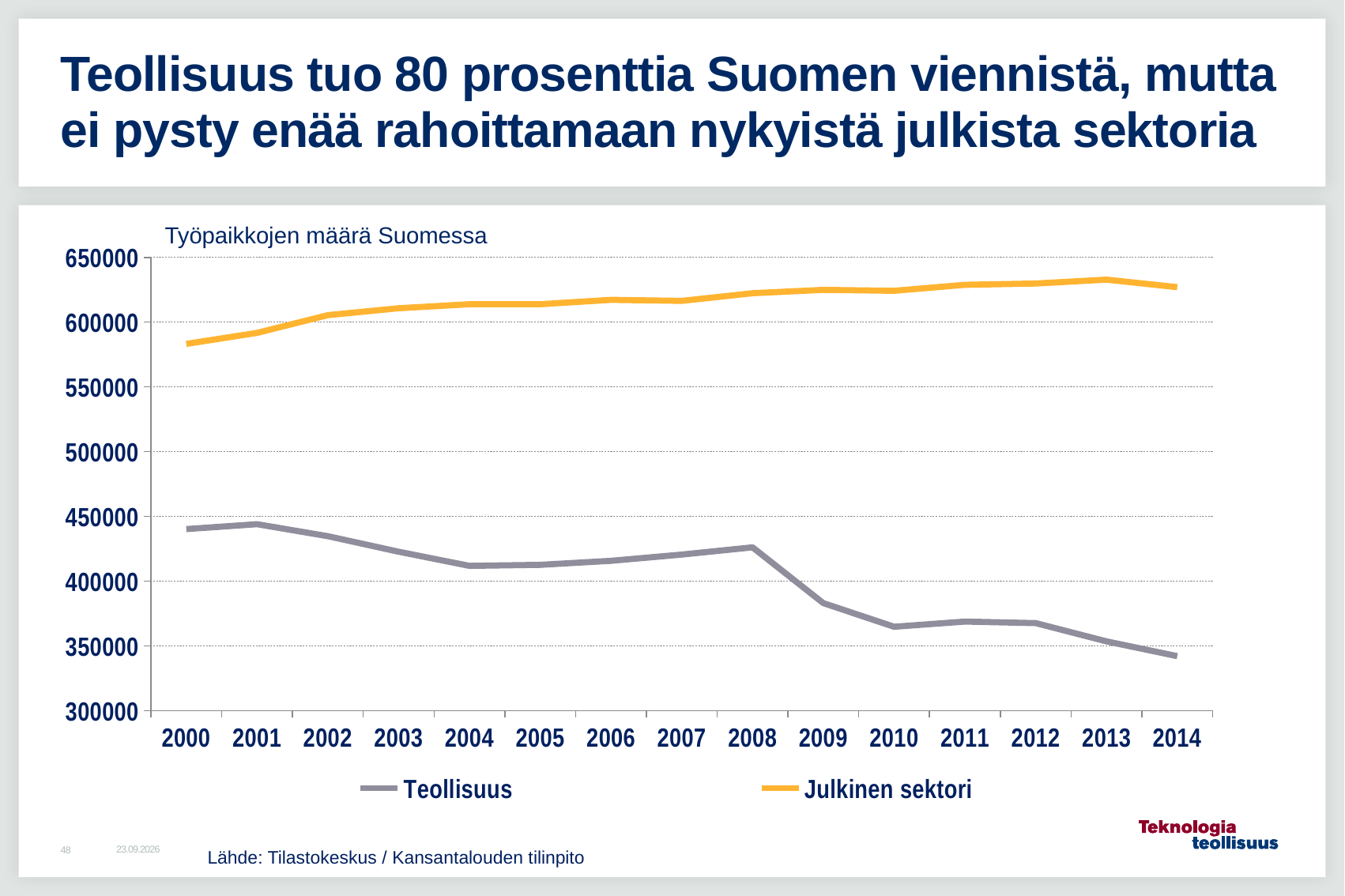
In which year is the Julkinen sektori value lowest? 2000 In which year is the Julkinen sektori value highest? 2013 What is the title of the chart? Työpaikkojen määrä Suomessa Does the Julkinen sektori series rise or fall overall from 2000 to 2014? Rise Is the Julkinen sektori value for 2000 greater or less than 600000? less Is the Teollisuus value for 2014 greater or less than 350000? less How many series does the legend list? 2 Does the Teollisuus series rise or fall overall from 2000 to 2014? Fall How many years are shown on the x axis? 15 Which series is drawn in yellow? Julkinen sektori What kind of chart is shown on the slide? Line chart In which year is the Teollisuus value lowest? 2014